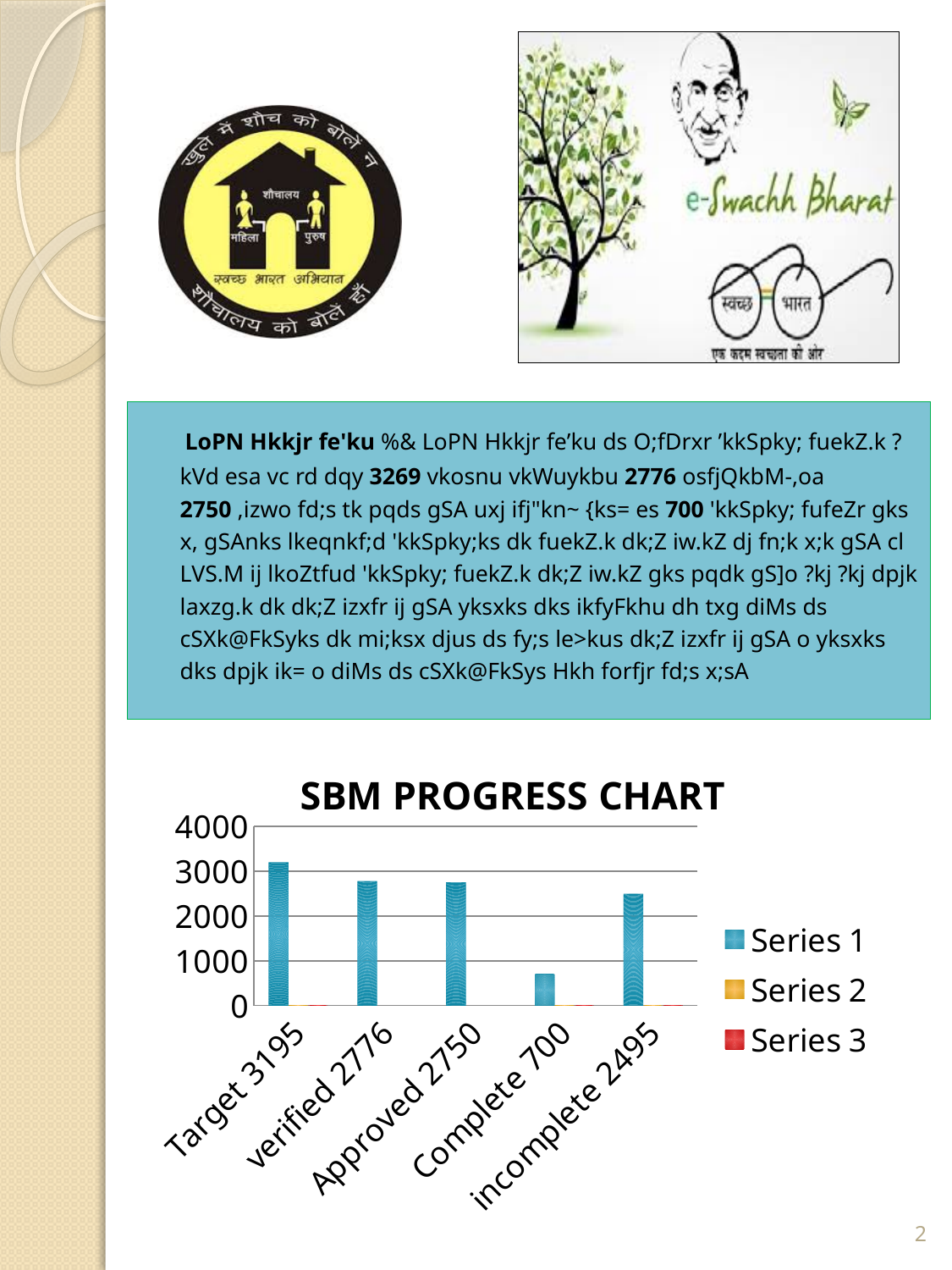
How many categories are shown on the x axis of the SBM PROGRESS CHART? 5 Which category has the tallest bar in the SBM PROGRESS CHART? Target 3195 Which bar is taller, verified or incomplete? verified Is the value for Target greater or less than 3000? greater What colour is Series 1 in the legend of the SBM PROGRESS CHART? blue What value is given for incomplete in the SBM PROGRESS CHART category label? 2495 How many series does the legend of the SBM PROGRESS CHART list? 3 What is the title of the chart on the slide? SBM PROGRESS CHART What kind of chart is the SBM PROGRESS CHART? bar chart Which category has the shortest bar in the SBM PROGRESS CHART? Complete 700 Is the value for Complete greater or less than 1000? less What value is given for Complete in the SBM PROGRESS CHART category label? 700